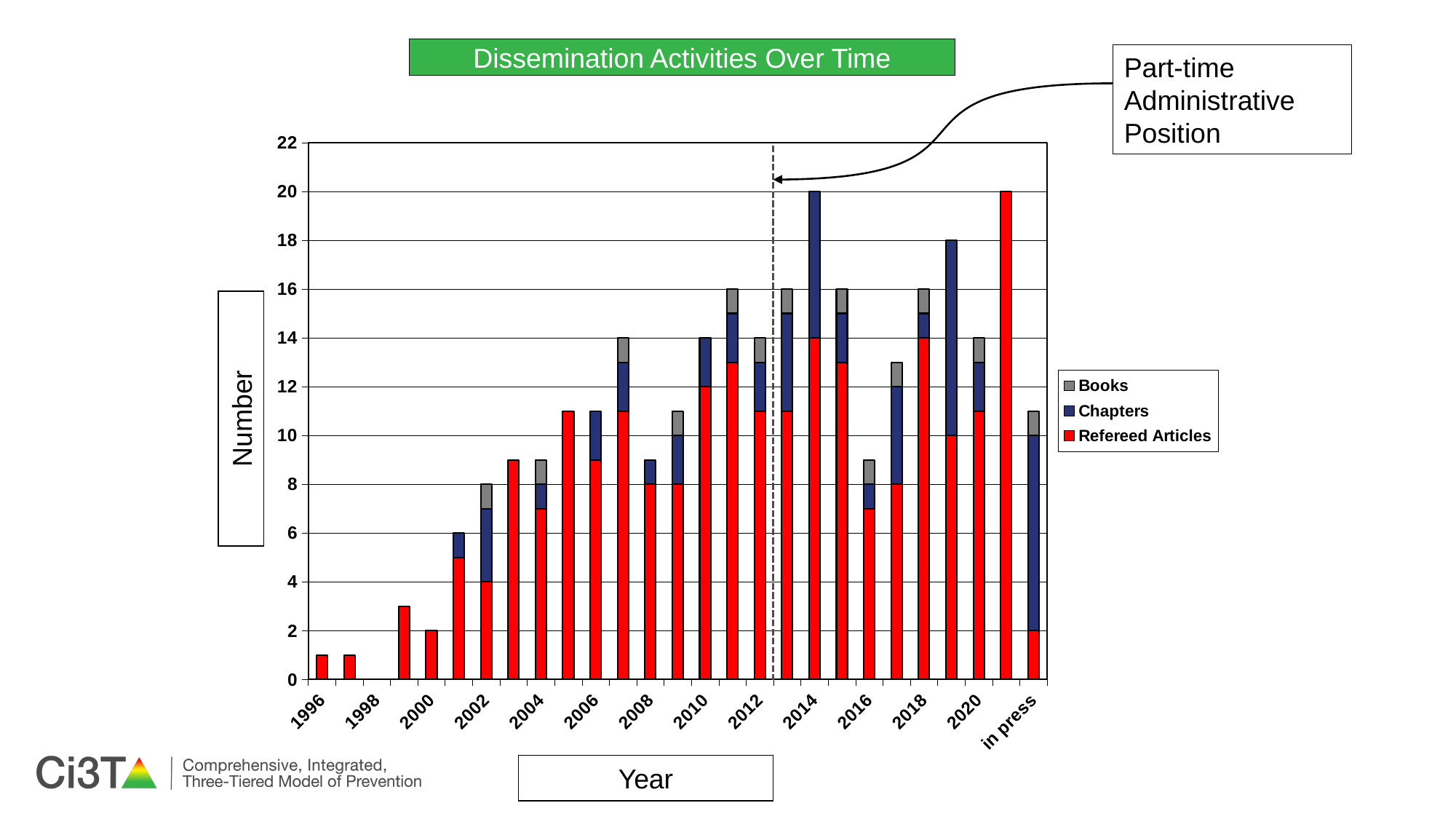
What is the total height of the stacked bar for 2019? 18 How many Refereed Articles are shown for the 'in press' bar? 2 What is the total height of the stacked bar for 2000? 2 Which year has the taller stacked bar, 2019 or 2020? 2019 What is the difference between the total for 2014 and the total for 2013? 4 Is the total for 2016 greater or less than 10? less What kind of chart is shown on the slide? Stacked bar chart How many series does the legend list? 3 Is the total for the 'in press' bar greater or less than 10? greater What are the three series named in the legend? Books, Chapters, Refereed Articles How many Refereed Articles are shown for 2014? 14 What is the total height of the stacked bar for 2014? 20